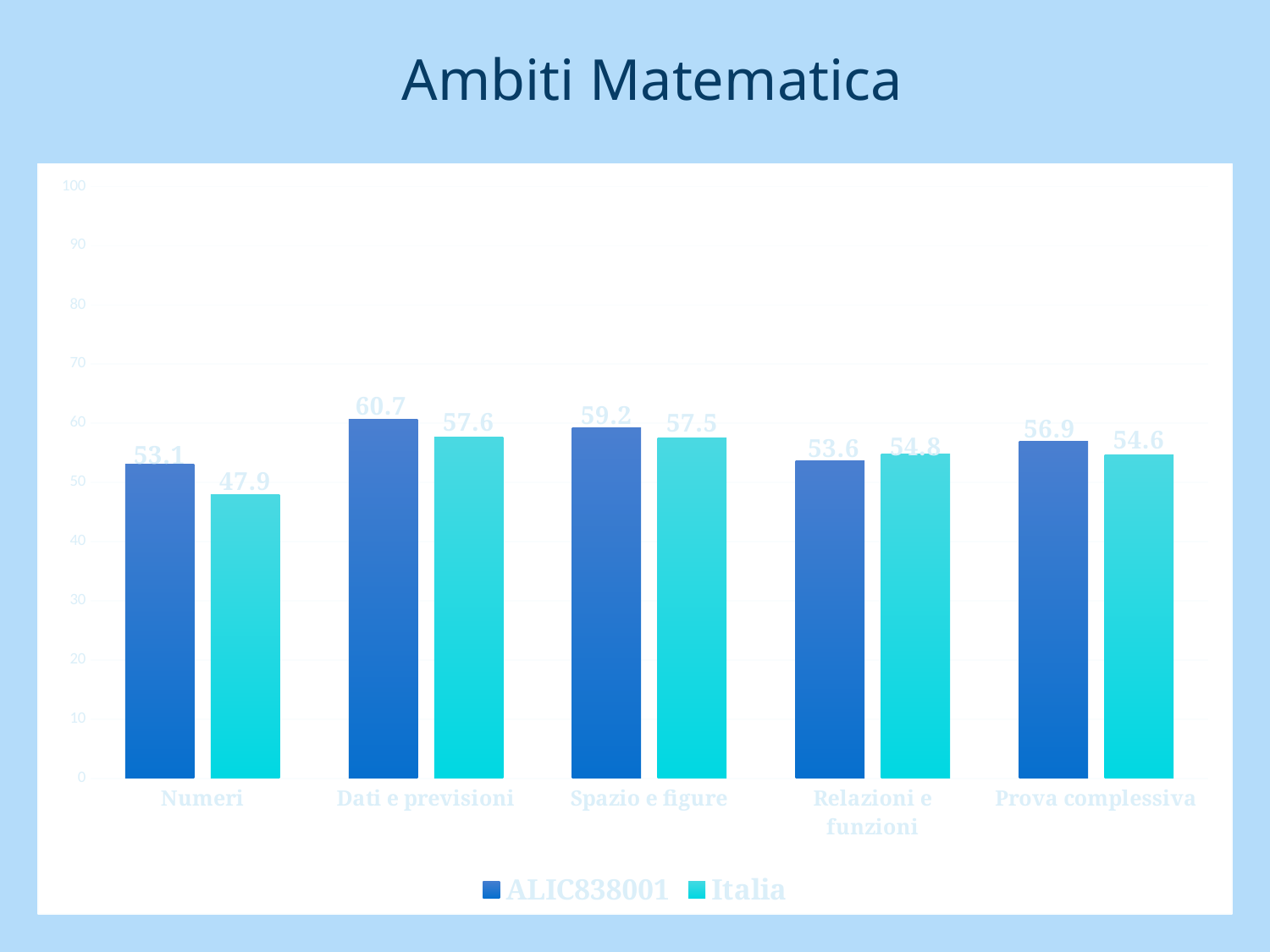
What is the difference between the ALIC838001 and Italia values in the Numeri category? 5.2 What is the value for Italia in the Prova complessiva category? 54.6 Is the value for ALIC838001 in Dati e previsioni greater or less than 60? greater How many categories are shown on the x axis? 5 In the Relazioni e funzioni category, which series has the larger value, ALIC838001 or Italia? Italia Which category has the lowest value for Italia? Numeri What is the title of the chart? Ambiti Matematica What kind of chart is shown on the slide? bar chart What is the value for ALIC838001 in the Numeri category? 53.1 Which category has the highest value for ALIC838001? Dati e previsioni How many series does the legend list? 2 What is the value for Italia in the Dati e previsioni category? 57.6